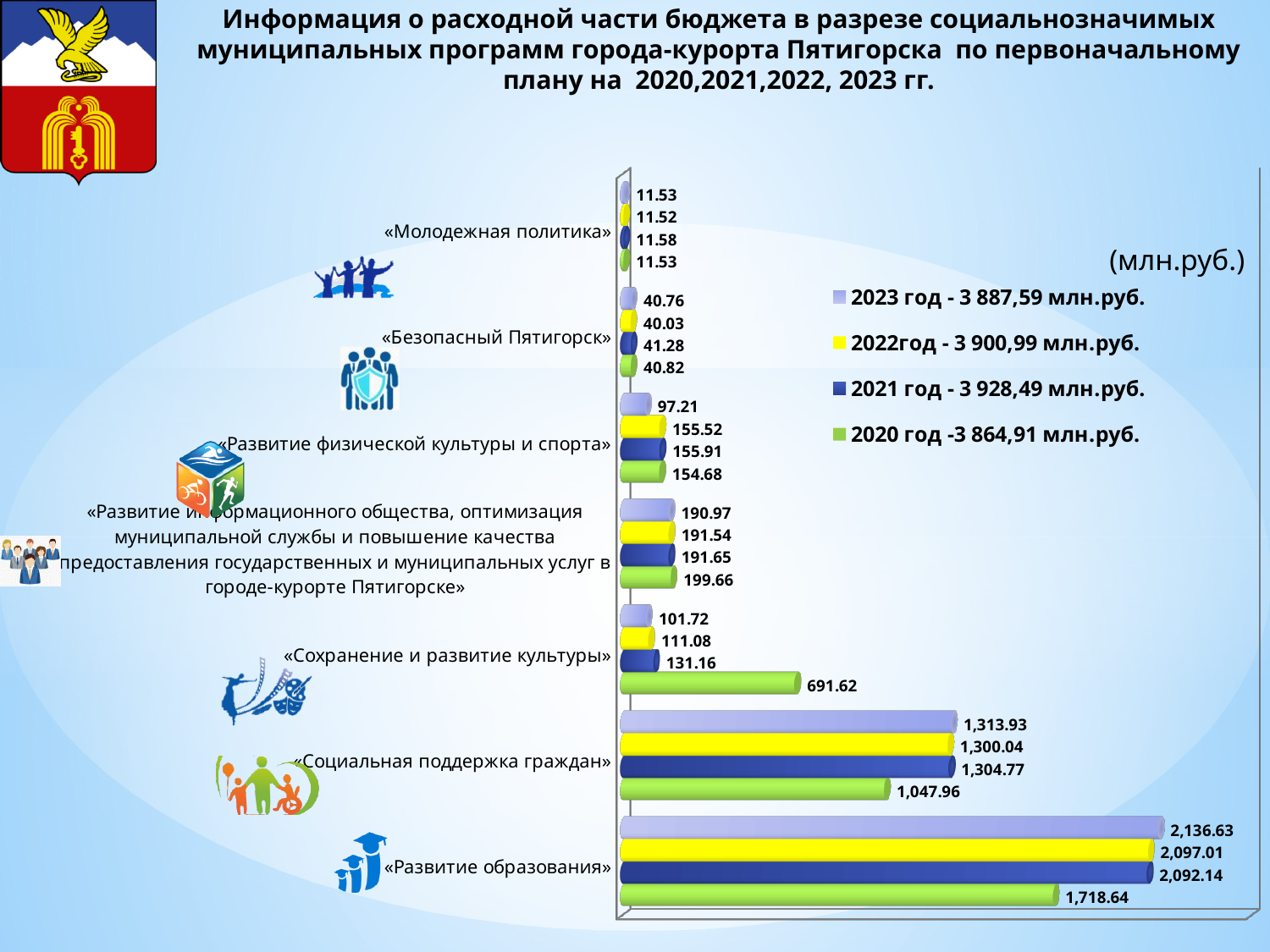
How many series does the legend list? 4 What is the value for «Сохранение и развитие культуры» in the 2020 series? 691.62 Which category has the highest value in the 2022 series? «Развитие образования» How many program categories are shown on the chart? 7 What is the value for «Развитие образования» in the 2023 series? 2,136.63 What is the value for «Безопасный Пятигорск» in the 2021 series? 41.28 Which is larger for «Развитие физической культуры и спорта»: the 2023 value or the 2022 value? 2022 What type of chart is shown on the slide? bar chart What is the difference between the 2021 and 2022 values for «Сохранение и развитие культуры»? 20.08 According to the legend, what is the total budget for 2021? 3 928,49 млн.руб. Which category has the lowest value in the 2020 series? «Молодежная политика» What is the difference between the 2023 and 2020 values for «Социальная поддержка граждан»? 265.97